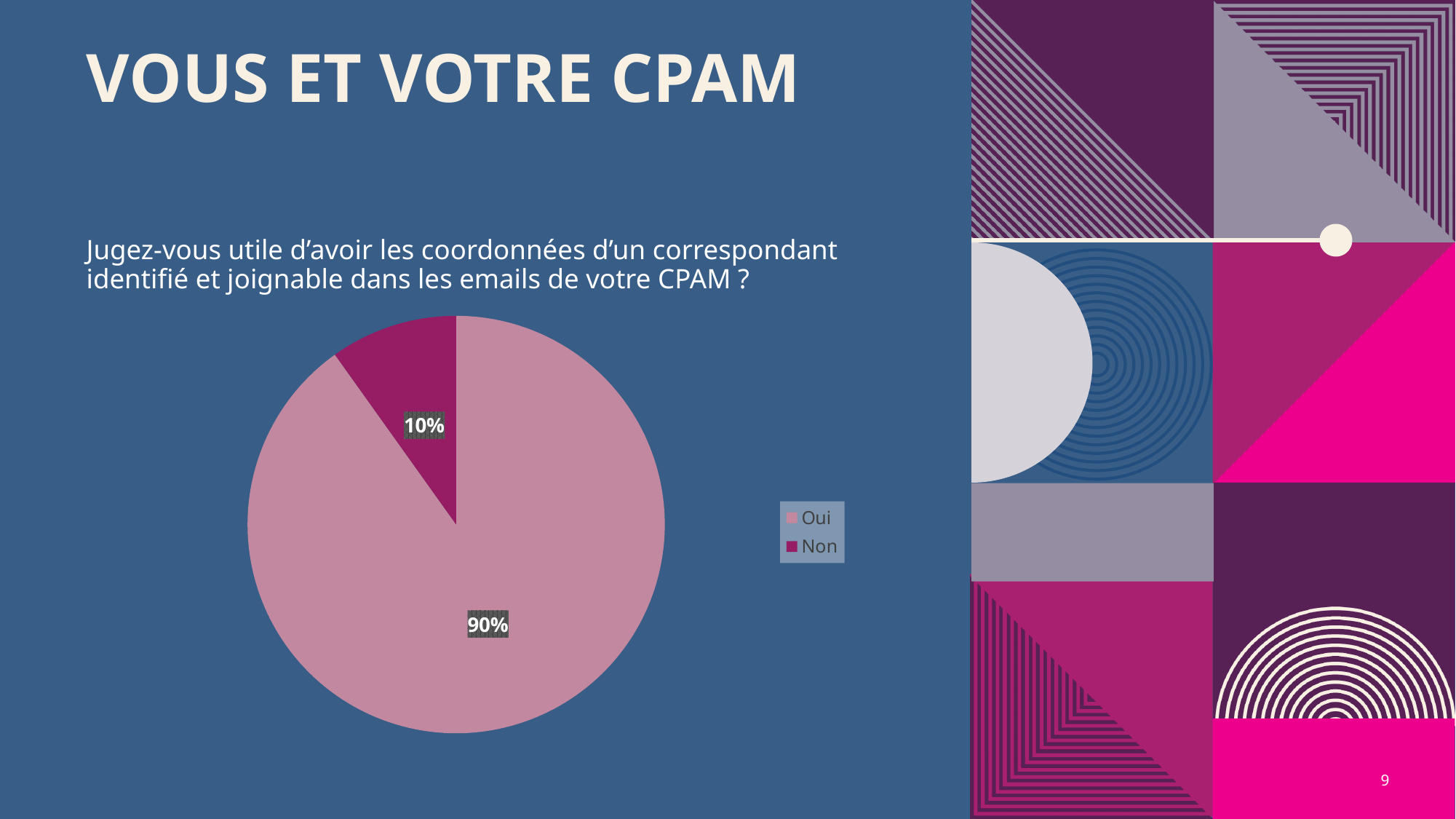
Which slice is larger, "Oui" or "Non"? Oui What share of the pie does "Non" represent? 10% What is the difference in percentage points between the "Oui" and "Non" slices? 80 Which category has the largest slice of the pie? Oui What question does the pie chart answer, according to the text above it? Jugez-vous utile d’avoir les coordonnées d’un correspondant identifié et joignable dans les emails de votre CPAM ? Which category has the smallest slice of the pie? Non How many entries does the legend list? 2 How many categories does the pie chart show? 2 What share of the pie does "Oui" represent? 90% What kind of chart is shown on the slide? pie chart What are the two legend entries of the pie chart? Oui and Non